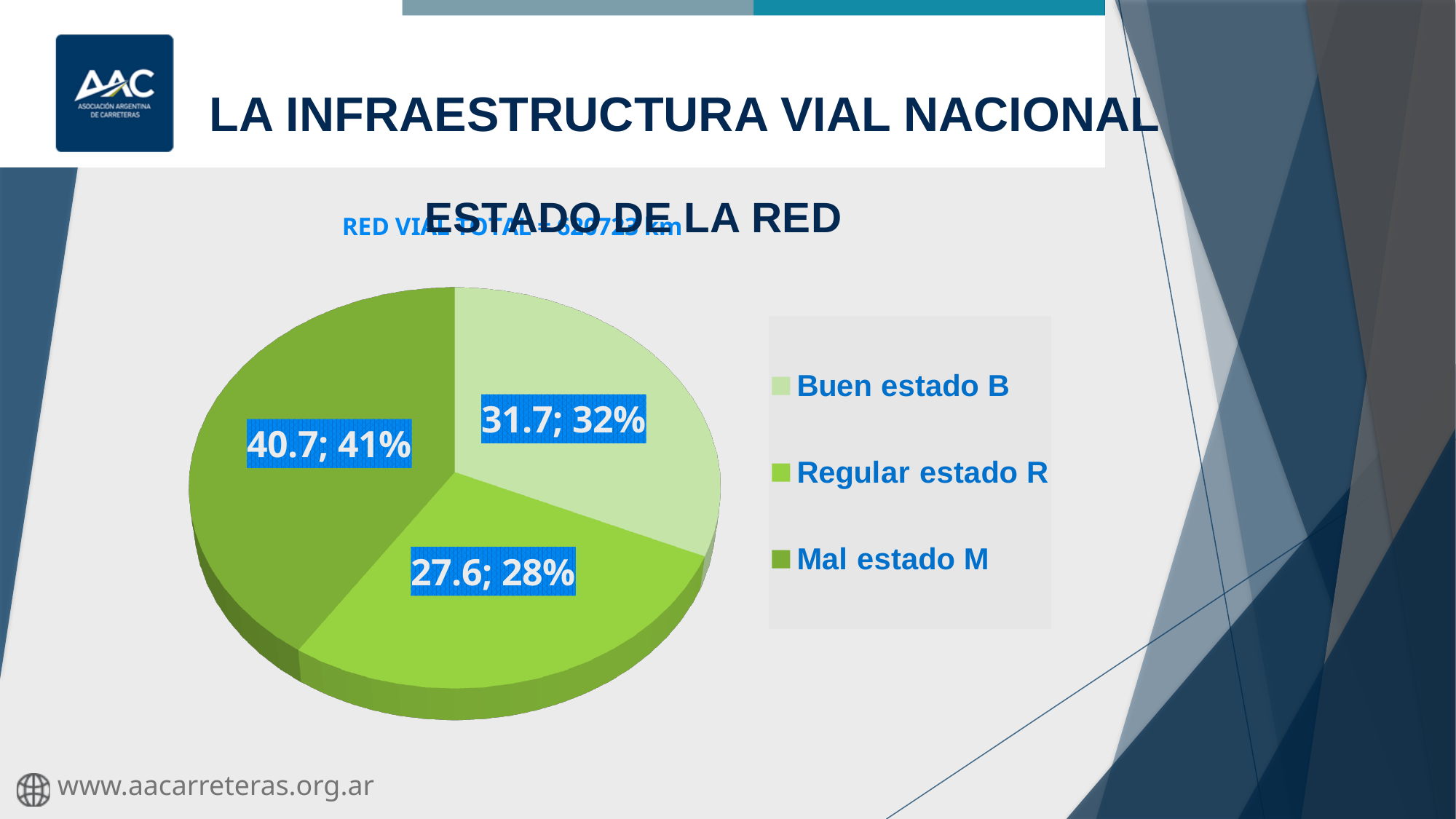
Which is larger, the value for Buen estado B or the value for Mal estado M? Mal estado M What percentage share of the pie does Regular estado R represent? 28% How many entries does the legend list? 3 What percentage share of the pie does Mal estado M represent? 41% What value is shown for the Mal estado M slice? 40.7; 41% How many slices does the pie chart have? 3 Which category has the largest slice of the pie? Mal estado M What value is shown for the Regular estado R slice? 27.6; 28% Which category has the smallest slice of the pie? Regular estado R What value is shown for the Buen estado B slice? 31.7; 32% What is the difference between the values for Mal estado M (40.7) and Regular estado R (27.6)? 13.1 What kind of chart is shown on the slide? Pie chart